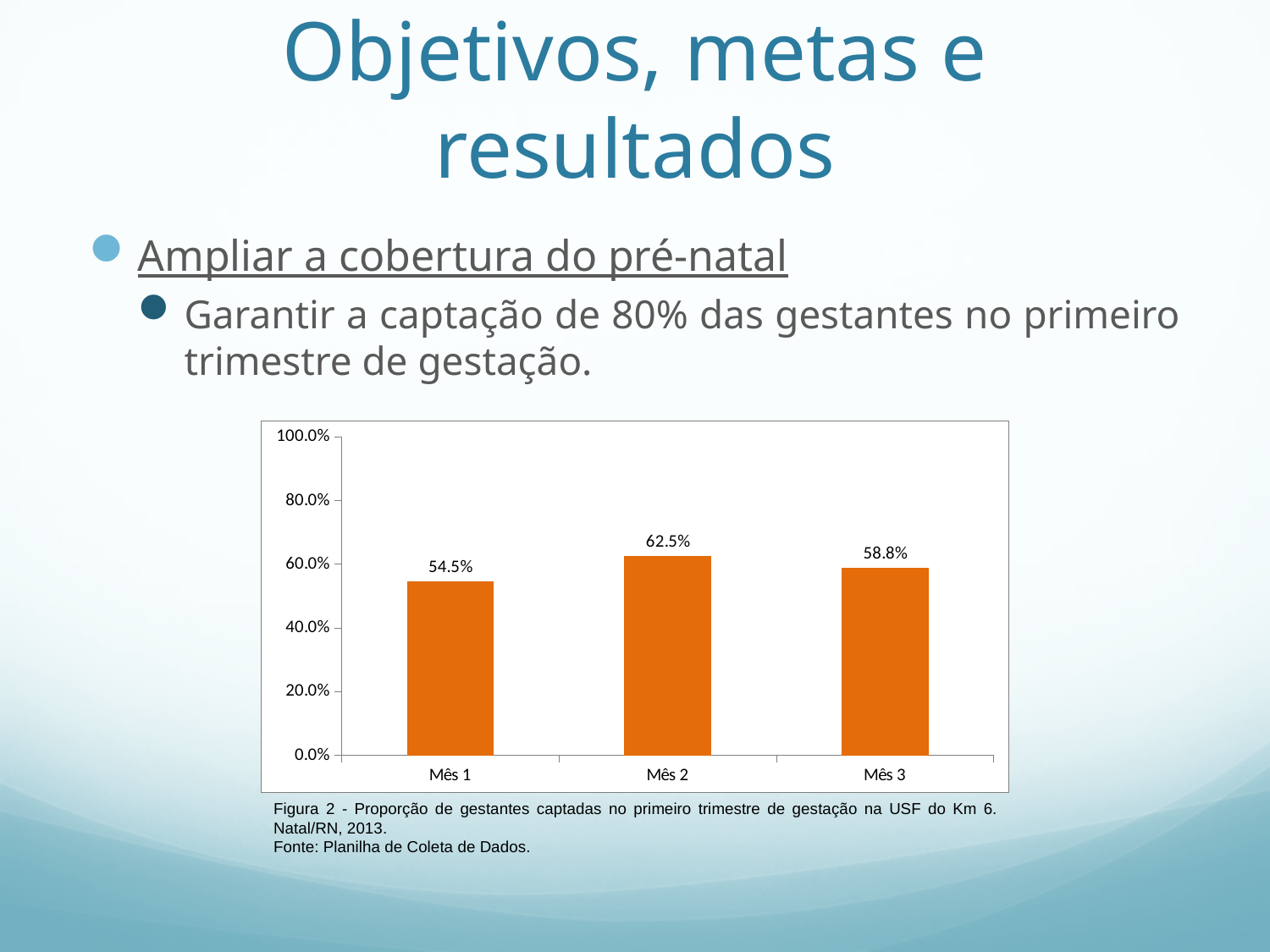
Which month has the lowest value? Mês 1 How many categories are shown on the x axis? 3 What is the difference between the values for Mês 2 and Mês 1? 8.0% What is the difference between the values for Mês 2 and Mês 3? 3.7% Which is larger, the value for Mês 3 or the value for Mês 1? Mês 3 What colour are the bars in the chart? orange Is the value for Mês 2 greater or less than 80.0%? less What is the value for Mês 3? 58.8% What is the value for Mês 2? 62.5% Which month has the highest value? Mês 2 What is the value for Mês 1? 54.5% What kind of chart is shown on the slide? bar chart